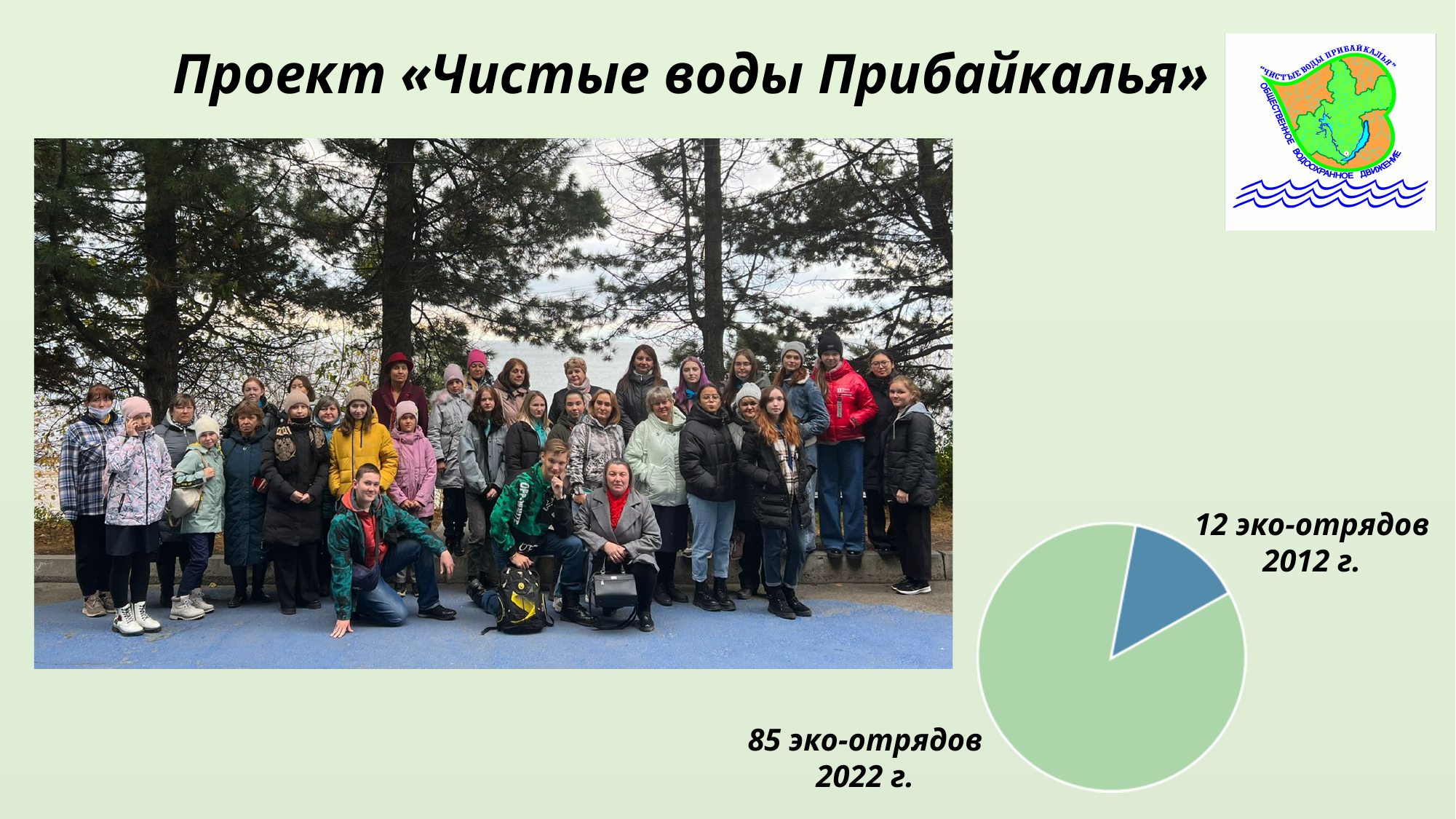
What kind of chart is shown on the slide? pie chart Which year has the smaller slice in the pie chart? 2012 г. What colour is the slice for 2022 г. in the pie chart? green What colour is the slice for 2012 г. in the pie chart? blue How many slices does the pie chart have? 2 How many эко-отрядов does the pie chart show for 2012 г.? 12 How many эко-отрядов does the pie chart show for 2022 г.? 85 By how many did the number of эко-отрядов increase from 2012 г. to 2022 г.? 73 Which year has the larger slice in the pie chart? 2022 г. Is the number of эко-отрядов larger in 2012 г. or in 2022 г.? 2022 г.